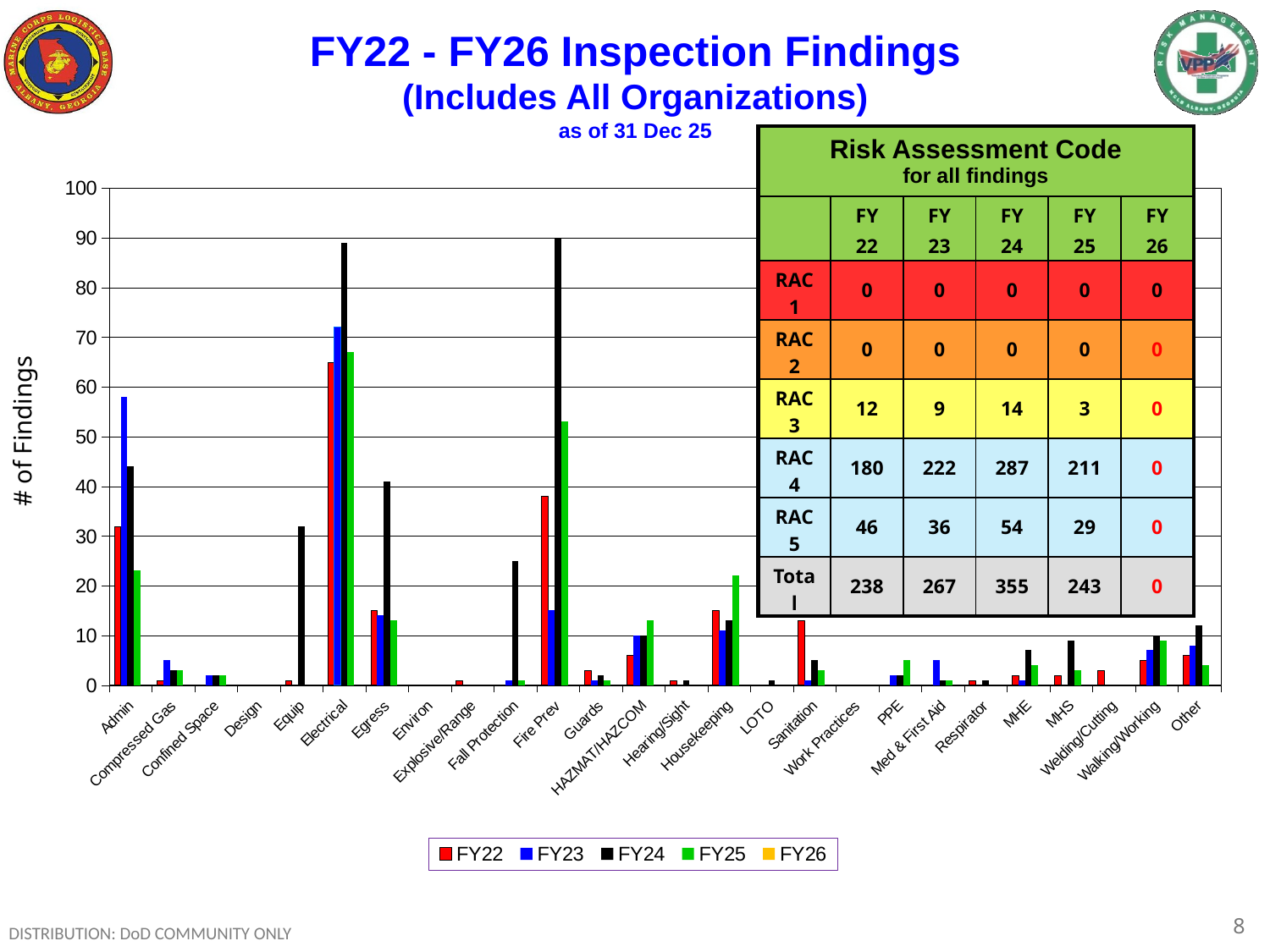
Which category has the tallest FY23 bar? Electrical Is the FY24 value for Egress greater or less than 30? greater How many categories are shown along the x axis of the inspection findings chart? 26 What is the label on the vertical axis of the inspection findings chart? # of Findings For Fire Prev, which is larger: the FY24 value or the FY22 value? FY24 Is the FY24 value for Electrical greater or less than 80? greater How many series does the legend of the inspection findings chart list? 5 Is the FY23 value for Admin greater or less than 50? greater Which colour represents FY24 in the inspection findings chart legend? black Which category has the tallest FY22 bar? Electrical What kind of chart is used to show the FY22 - FY26 Inspection Findings? bar chart